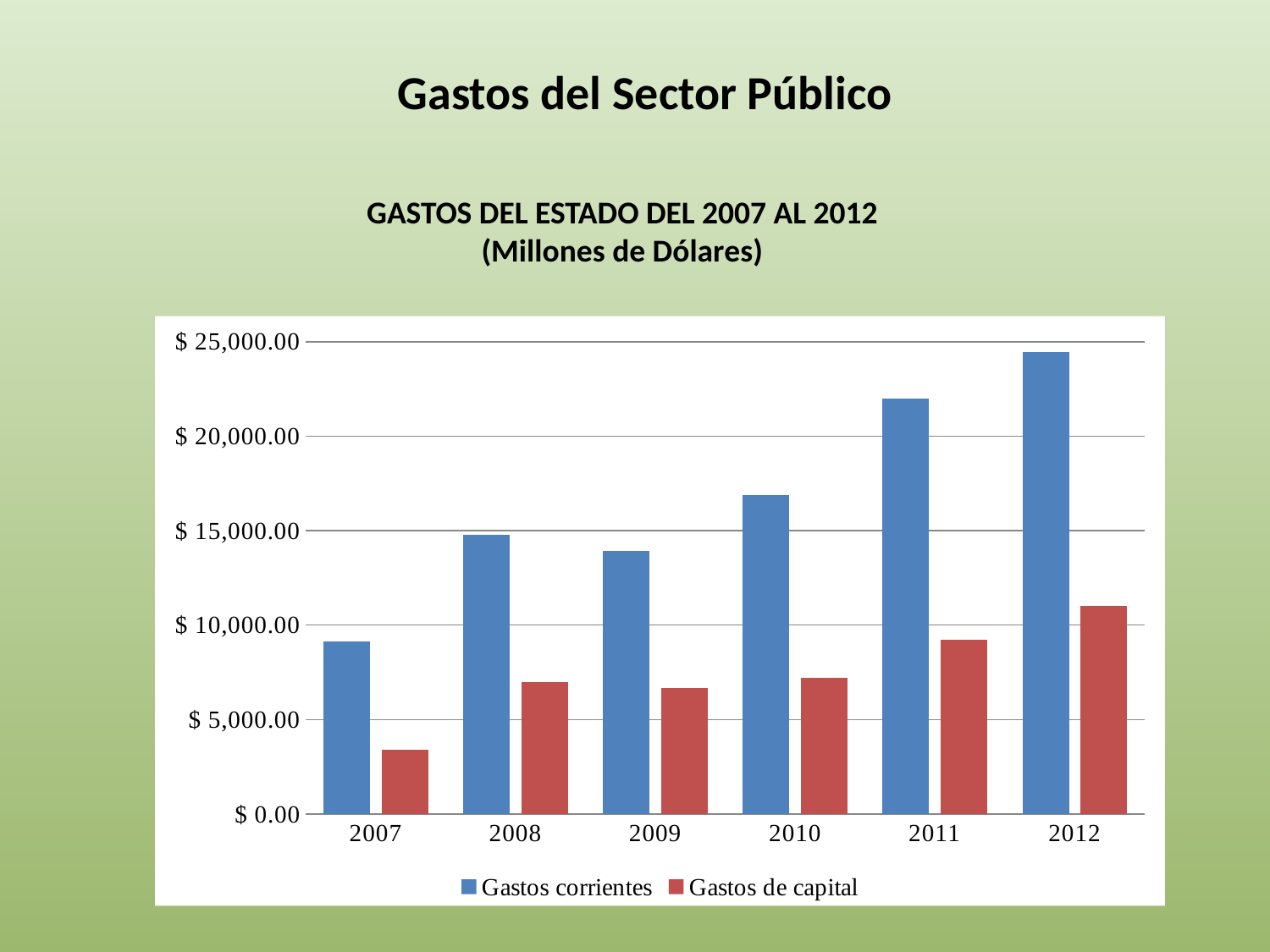
Is the value for Gastos corrientes in 2012 greater or less than $ 20,000.00? greater What kind of chart is shown on the slide? bar chart Between 2010 and 2012, do the values for Gastos corrientes rise or fall? rise Which year has the highest value for Gastos corrientes? 2012 Which year has the lowest value for Gastos corrientes? 2007 Which year has the lowest value for Gastos de capital? 2007 Is the value for Gastos de capital in 2007 greater or less than $ 5,000.00? less How many series does the legend list? 2 What is the title of the chart? GASTOS DEL ESTADO DEL 2007 AL 2012 (Millones de Dólares) How many years are shown on the x axis? 6 Is the value for Gastos corrientes in 2007 greater or less than $ 10,000.00? less Which is larger, Gastos corrientes in 2008 or Gastos corrientes in 2009? 2008